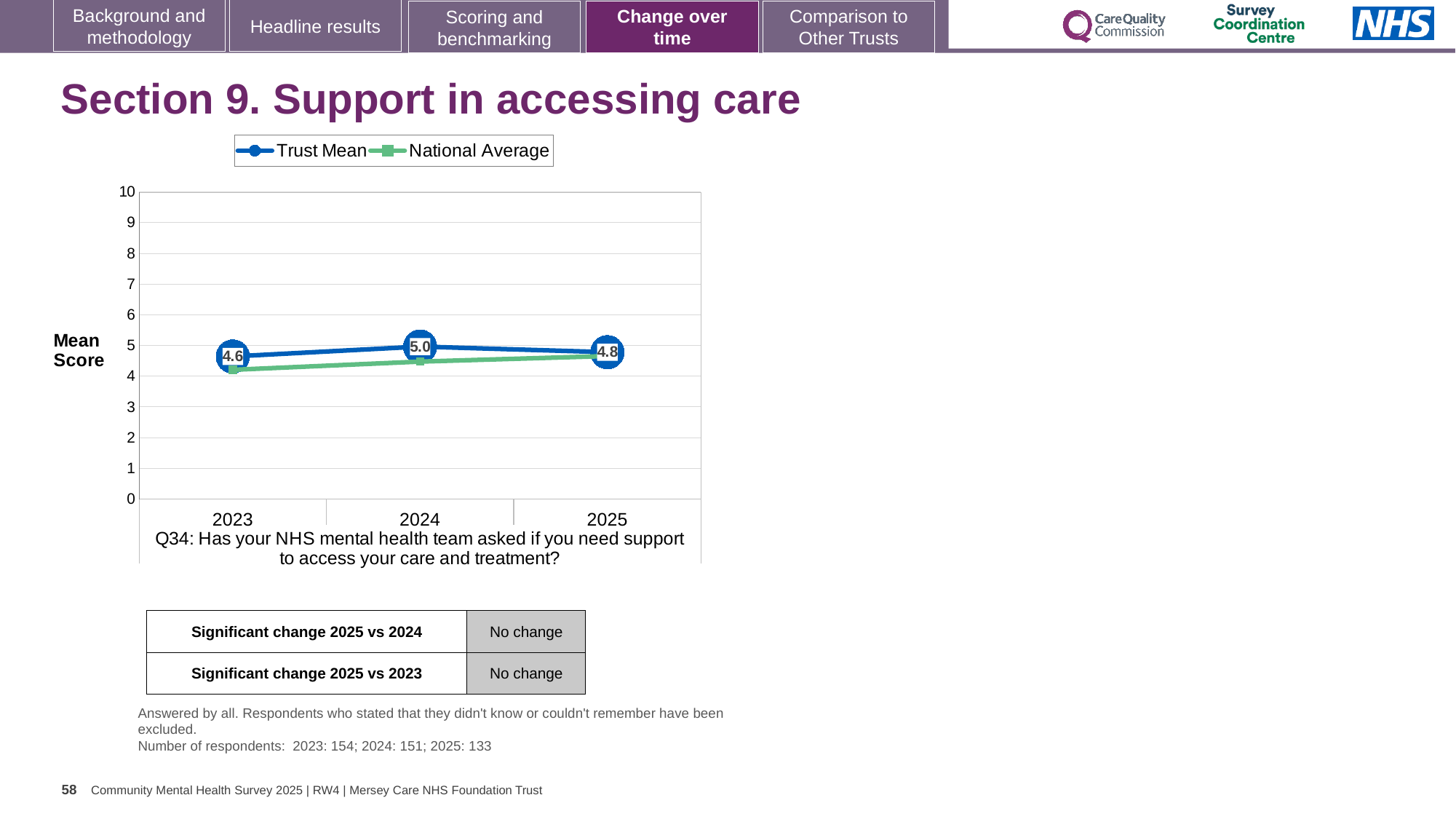
What kind of chart is shown? line chart Does the National Average rise or fall from 2023 to 2025? rise Is the National Average value for 2023 greater or less than 5? less How many years are plotted on the x axis? 3 What is the difference between the Trust Mean in 2024 and in 2023? 0.4 In which year is the Trust Mean lowest? 2023 In which year is the Trust Mean highest? 2024 What is the Trust Mean score for 2025? 4.8 What is the Trust Mean score for 2023? 4.6 How many series does the legend list? 2 What is the Trust Mean score for 2024? 5.0 Which is larger in 2023, the Trust Mean or the National Average? Trust Mean